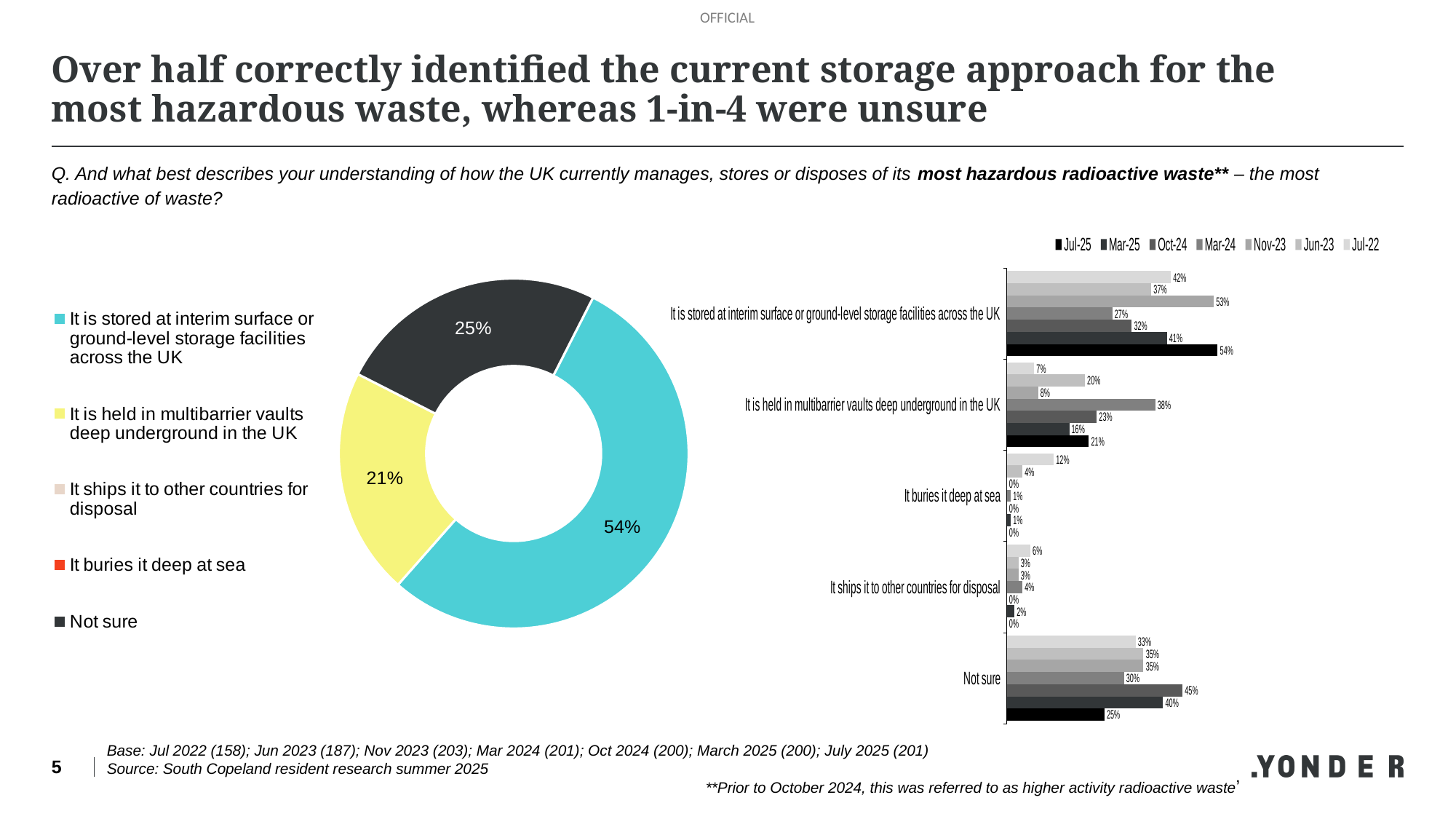
On the right-hand bar chart, which survey wave has the highest value for 'It is held in multibarrier vaults deep underground in the UK'? Mar-24 On the donut chart on the left, what is the difference in percentage points between the 'Not sure' share and the 'multibarrier vaults' share? 4 percentage points What type of chart is shown on the right-hand side of the slide? Bar chart On the right-hand bar chart, what is the Jul-25 value for 'Not sure'? 25% On the donut chart on the left, how many response options does the legend list? 5 On the right-hand bar chart, what is the Jul-22 value for 'It buries it deep at sea'? 12% How many survey waves does the legend of the right-hand bar chart list? 7 On the donut chart on the left, what share of respondents said the waste is held in multibarrier vaults deep underground in the UK? 21% On the donut chart on the left, what share of respondents said the waste is stored at interim surface or ground-level storage facilities across the UK? 54% On the donut chart on the left, which response has the largest share? It is stored at interim surface or ground-level storage facilities across the UK On the donut chart on the left, what share of respondents said they were not sure? 25% On the right-hand bar chart, is the Jul-25 value for 'It is stored at interim surface or ground-level storage facilities across the UK' larger or smaller than the Mar-25 value? Larger